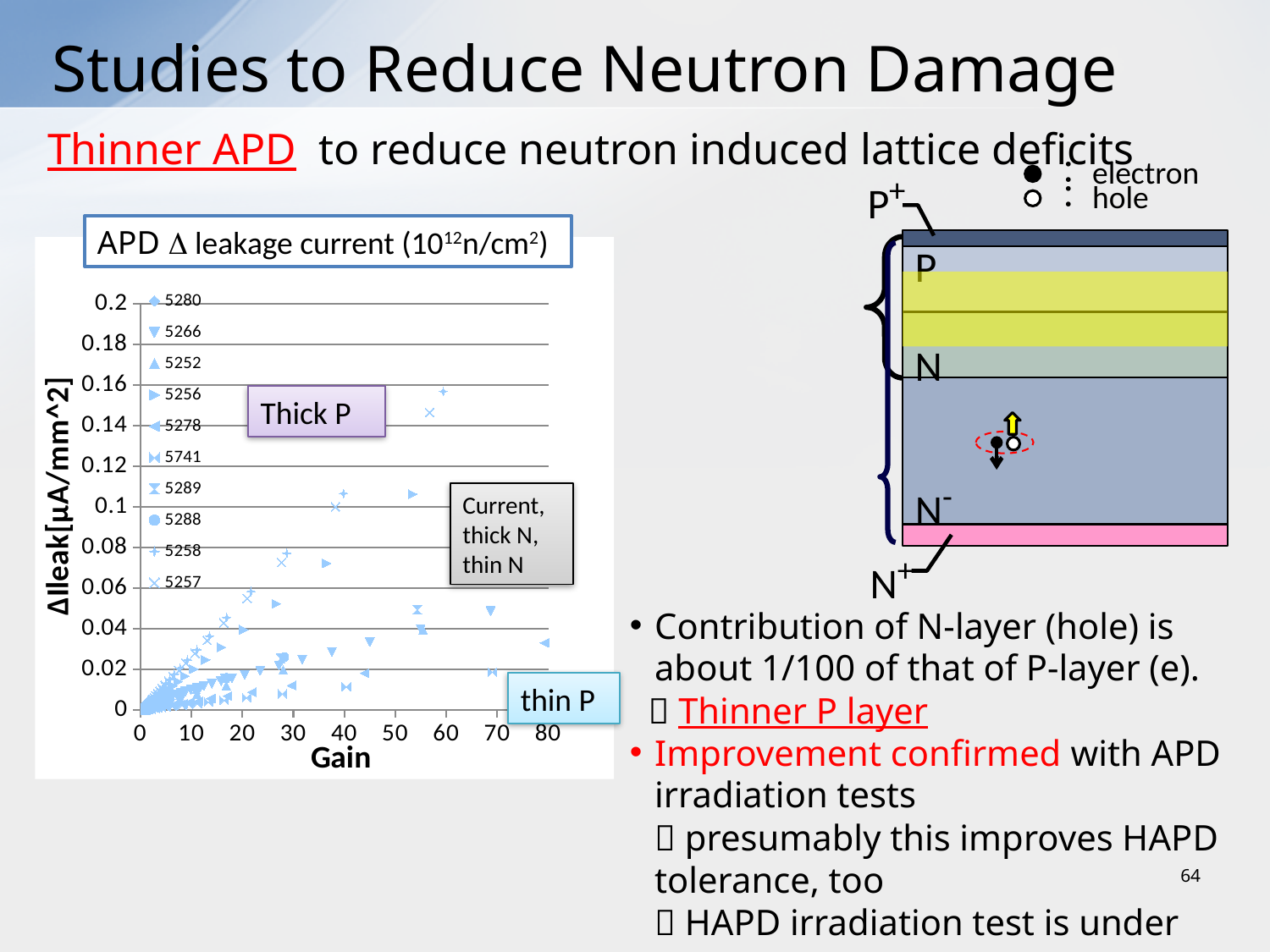
Is the highest plotted value in the chart greater or less than 0.18? less How many series does the legend of the chart list? 10 Is the highest plotted value in the chart greater or less than 0.14? greater What is the title of the chart? APD Δ leakage current (10^12 n/cm^2) What kind of chart is shown on the slide? scatter chart Which series is listed first in the chart legend? 5280 What is the highest tick value shown on the x axis of the chart? 80 Do the plotted leakage current values generally rise or fall as Gain increases? rise Which series is listed last in the chart legend? 5257 What is the highest tick value shown on the y axis of the chart? 0.2 What is the label of the x axis of the chart? Gain